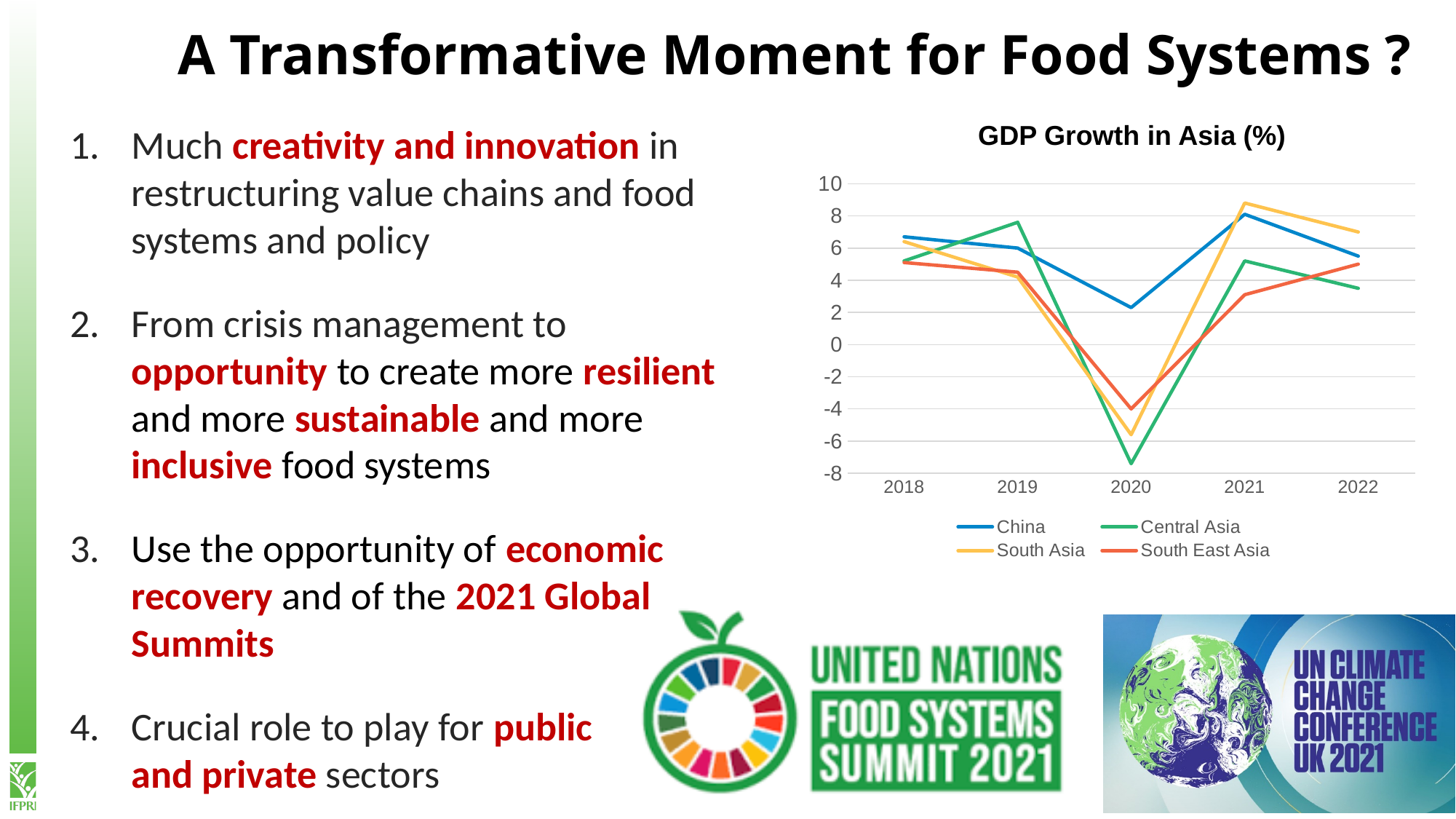
Is the value for China in 2020 greater or less than 0? greater What kind of chart is the GDP Growth in Asia (%) chart? line chart Is the value for South Asia in 2020 greater or less than -4? less In 2021, which is larger: the value for China or the value for South East Asia? China What is the title of the chart on the slide? GDP Growth in Asia (%) How many years are shown on the x axis of the GDP Growth in Asia (%) chart? 5 In which year does the Central Asia line reach its lowest value? 2020 Which series has the lowest value in 2020? Central Asia Which series has the highest value in 2021? South Asia Does the China line rise or fall from 2019 to 2020? fall How many series does the legend of the GDP Growth in Asia (%) chart list? 4 Which series has the highest value in 2019? Central Asia